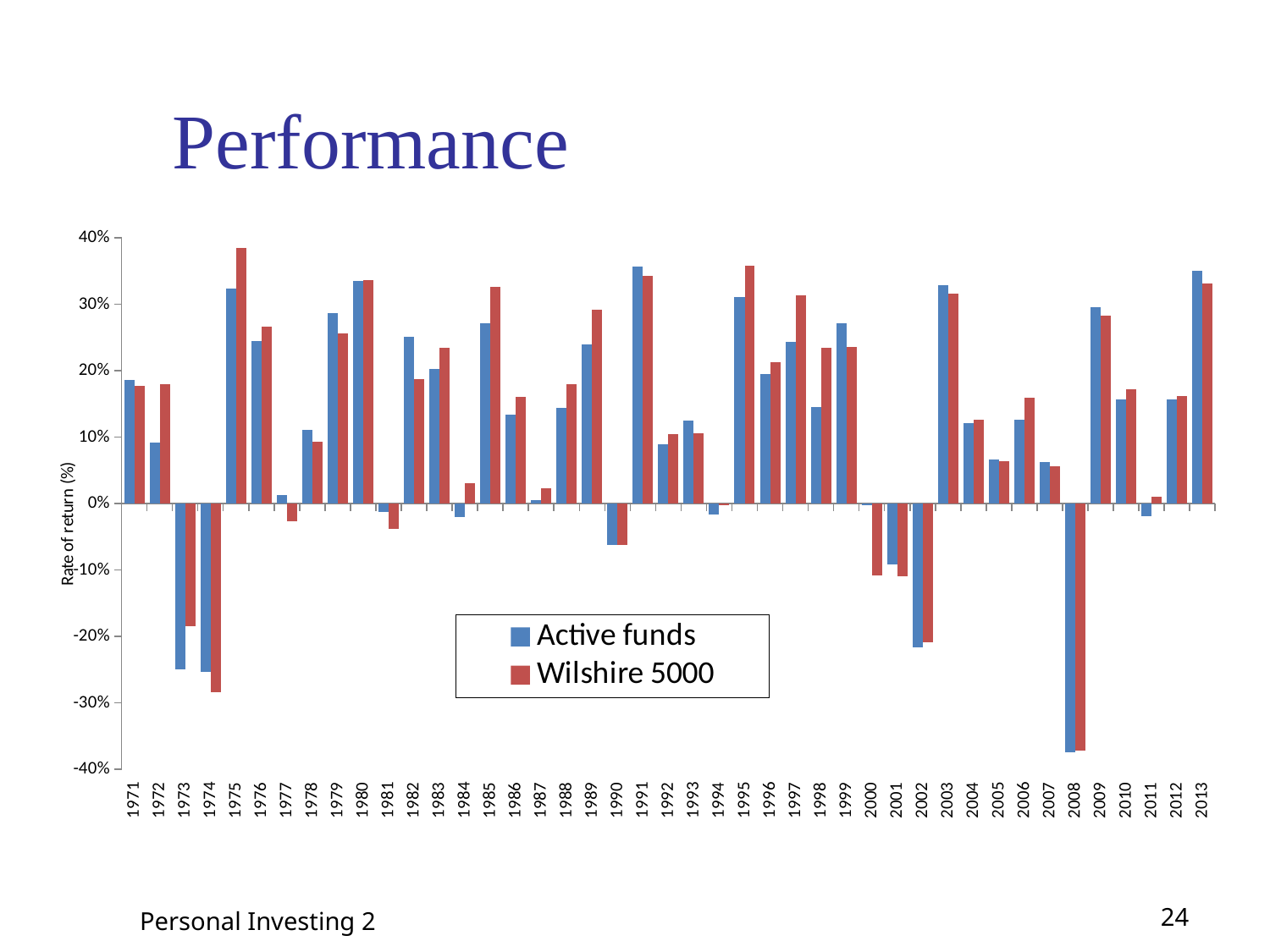
Is the Active funds value for 2008 greater or less than -30%? less What is the label on the vertical axis? Rate of return (%) How many series does the legend list? 2 In 1975, which series has the larger return, Active funds or Wilshire 5000? Wilshire 5000 How many years are shown along the x axis? 43 In which year is the Wilshire 5000 return the highest? 1975 In 1999, which series has the larger return, Active funds or Wilshire 5000? Active funds Is the Wilshire 5000 value for 1989 greater or less than 20%? greater In which year is the Wilshire 5000 return the lowest? 2008 What kind of chart is shown on the slide? Bar chart In 1997, which series has the larger return, Active funds or Wilshire 5000? Wilshire 5000 Is the Active funds value for 1973 greater or less than -20%? less